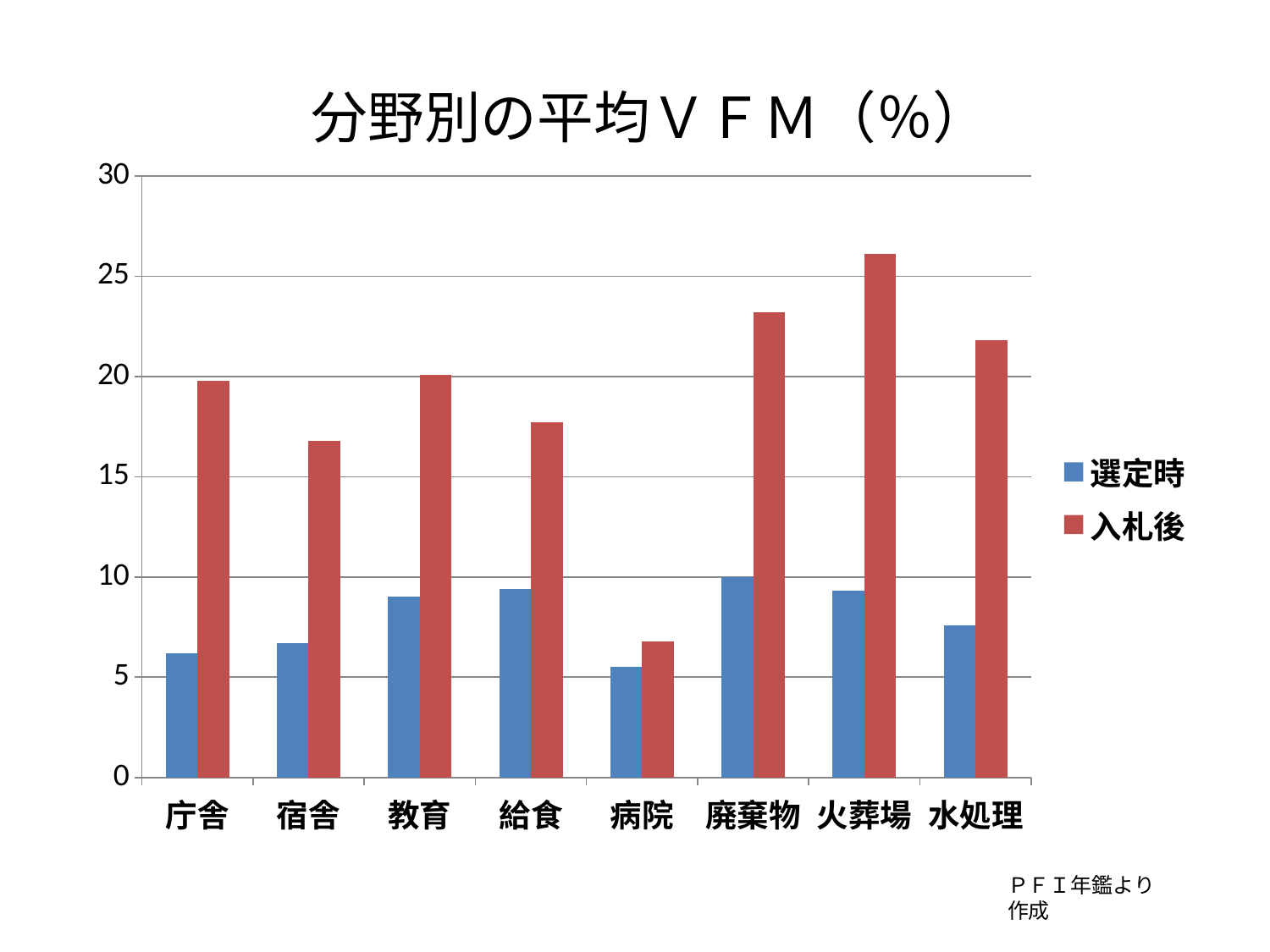
Which is larger, the 入札後 value for 廃棄物 or the 入札後 value for 水処理? 廃棄物 Which category has the highest 入札後 value? 火葬場 Is the 入札後 value for 給食 greater or less than 20? less Which is larger, the 入札後 value for 庁舎 or the 入札後 value for 宿舎? 庁舎 How many series does the legend list? 2 How many categories are shown on the x axis? 8 Is the 入札後 value for 火葬場 greater or less than 25? greater Which category has the lowest 選定時 value? 病院 What kind of chart is shown on the slide? bar chart Is the 入札後 value for 病院 greater or less than 10? less Which category has the lowest 入札後 value? 病院 What is the title of the chart? 分野別の平均ＶＦＭ（％）